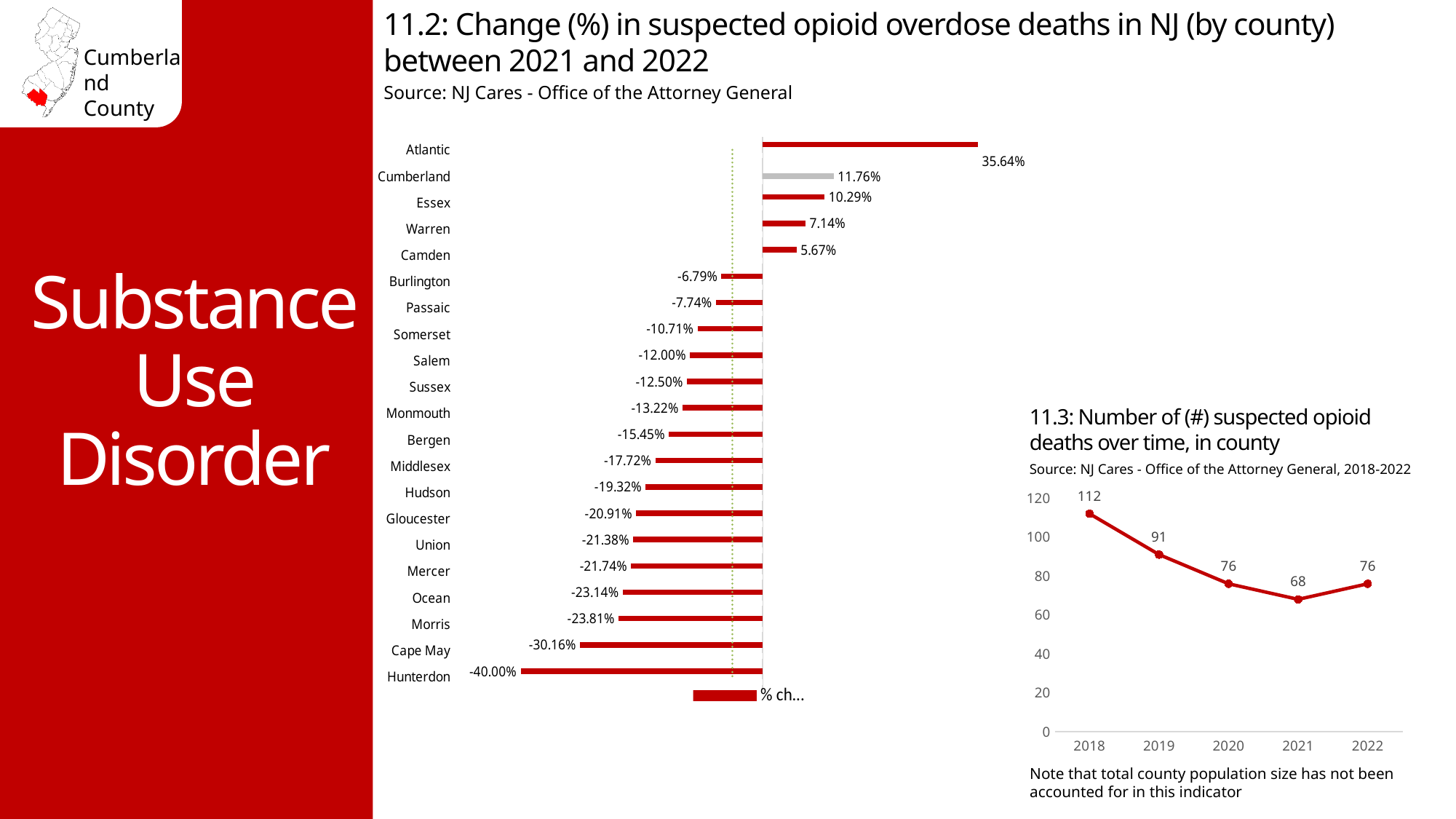
In chart 11.2, which county has the highest change (%) in suspected opioid overdose deaths? Atlantic In chart 11.3, how many suspected opioid deaths were there in 2018? 112 In chart 11.2, which county has a larger value, Essex or Warren? Essex In chart 11.2, which county has the lowest change (%) in suspected opioid overdose deaths? Hunterdon In chart 11.3, which year has the lowest number of suspected opioid deaths? 2021 In chart 11.3, what is the difference in suspected opioid deaths between 2018 and 2019? 21 In chart 11.2, what is the difference between the values for Atlantic and Cumberland? 23.88 percentage points In chart 11.3, how many data points are plotted? 5 In chart 11.2, what is the value shown for Hunterdon? -40.00% In chart 11.2, how many counties are shown? 21 What kind of chart is chart 11.2? Bar chart In chart 11.2, what is the change (%) in suspected opioid overdose deaths for Cumberland? 11.76%